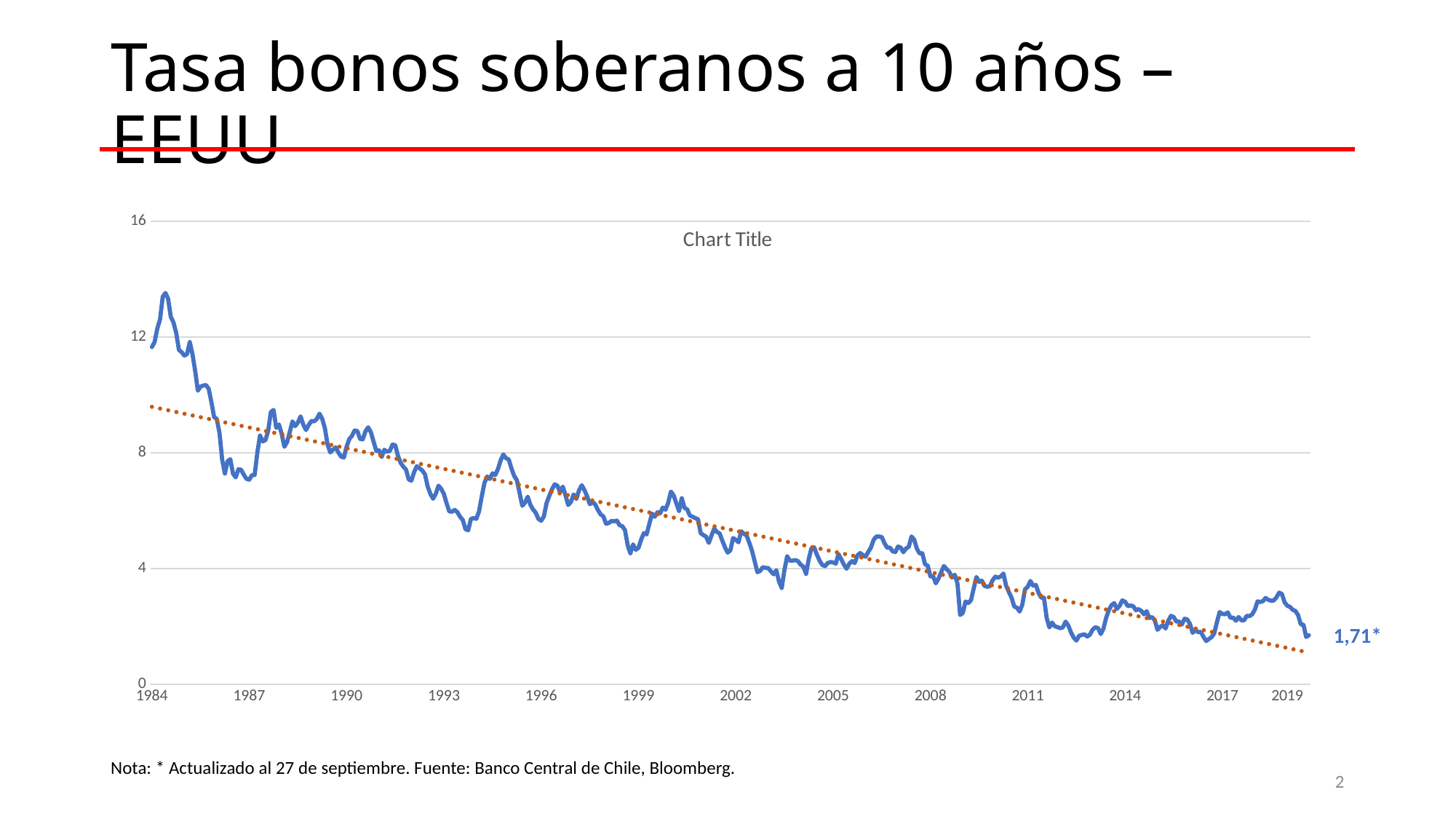
What kind of chart is shown on the slide? line chart What is the highest value shown on the vertical axis? 16 In which year labelled on the x axis does the blue line reach its highest value? 1984 Do the values of the blue line generally rise or fall from 1984 to 2019? fall Is the value of the blue line around 1996 greater or less than 12? less Is the value of the blue line around 2014 greater or less than 4? less Is the value of the blue line around 2008 greater or less than 8? less What is the value printed at the end of the blue line for 2019? 1,71* What title is printed inside the chart area? Chart Title How many year labels are shown on the x axis? 13